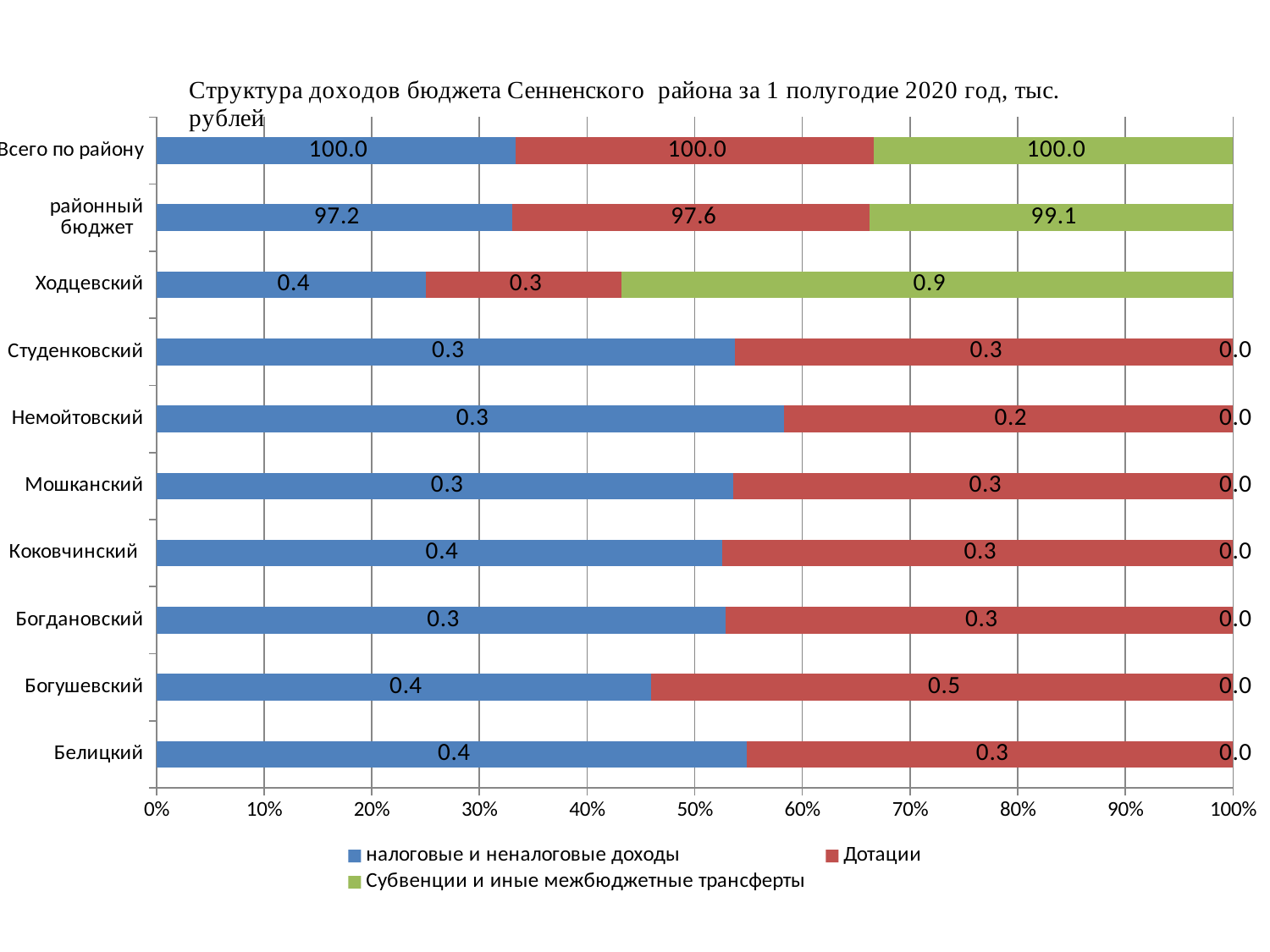
What is the value of Дотации for Немойтовский? 0.2 What is the value of Дотации for Богушевский? 0.5 What is the value of налоговые и неналоговые доходы for районный бюджет? 97.2 What is the value of Субвенции и иные межбюджетные трансферты for Ходцевский? 0.9 How many categories are shown on the vertical axis of the chart? 10 What is the title of the chart? Структура доходов бюджета Сенненского района за 1 полугодие 2020 год, тыс. рублей Which is larger: Дотации for Богушевский or Дотации for Белицкий? Богушевский How many series does the legend list? 3 Which category has the highest value for Дотации? Всего по району What is the difference between Субвенции и иные межбюджетные трансферты and налоговые и неналоговые доходы for районный бюджет? 1.9 What kind of chart is shown on the slide? Stacked bar chart What is the value of Субвенции и иные межбюджетные трансферты for районный бюджет? 99.1